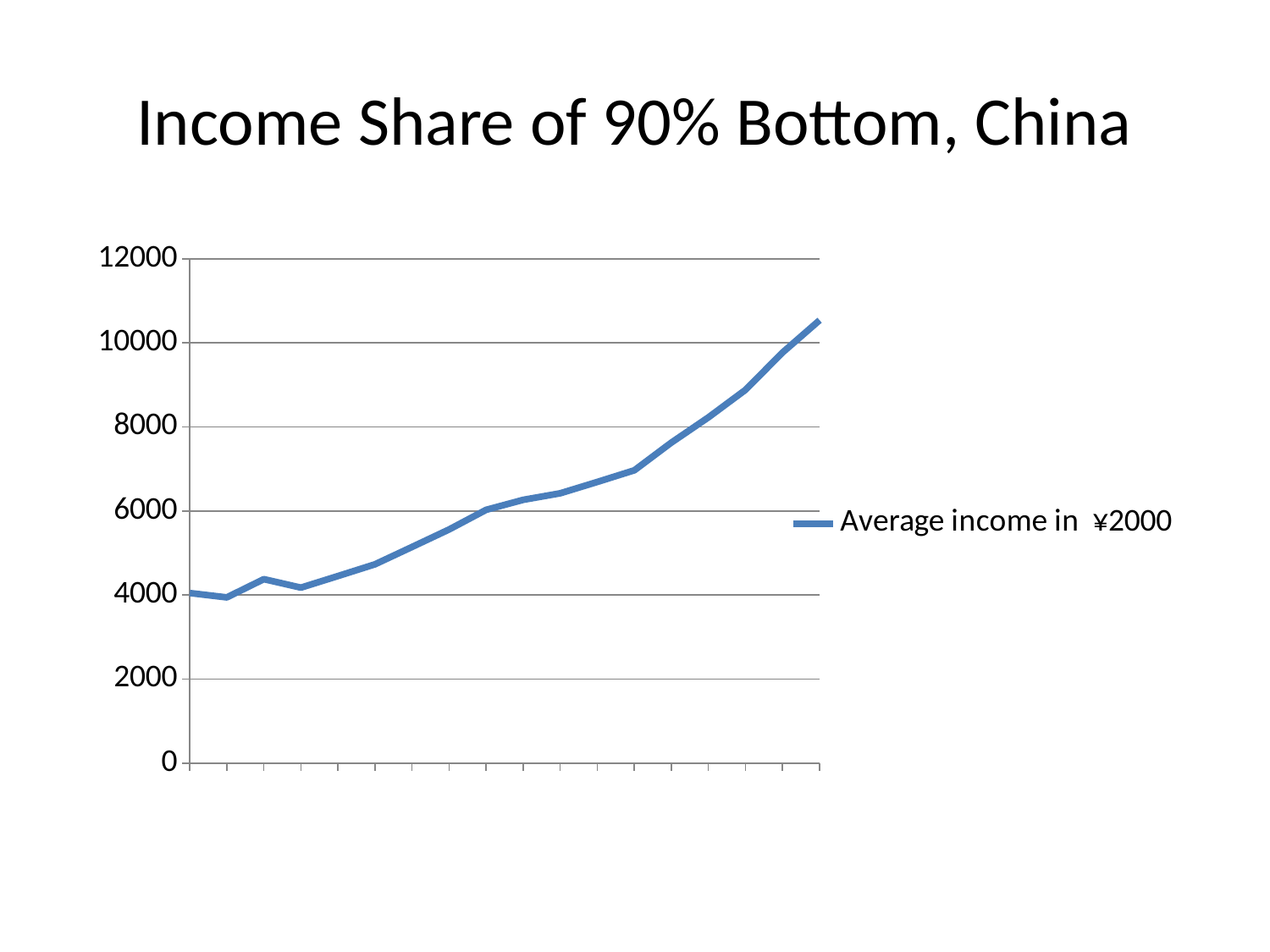
What is the title of the chart? Income Share of 90% Bottom, China Is the value at the rightmost point of the line greater or less than 8000? greater What is the name of the series shown in the legend? Average income in ¥2000 Is the value at the rightmost point of the line greater or less than 10000? greater How many series does the legend list? 1 Is the value at the leftmost point of the line greater or less than 2000? greater Which point on the line has the highest value, the leftmost or the rightmost? rightmost Overall, do the values rise or fall from left to right along the x axis? rise What is the highest value shown on the vertical axis? 12000 Which is larger, the value at the leftmost point or the value at the rightmost point? rightmost point What kind of chart is shown on the slide? line chart